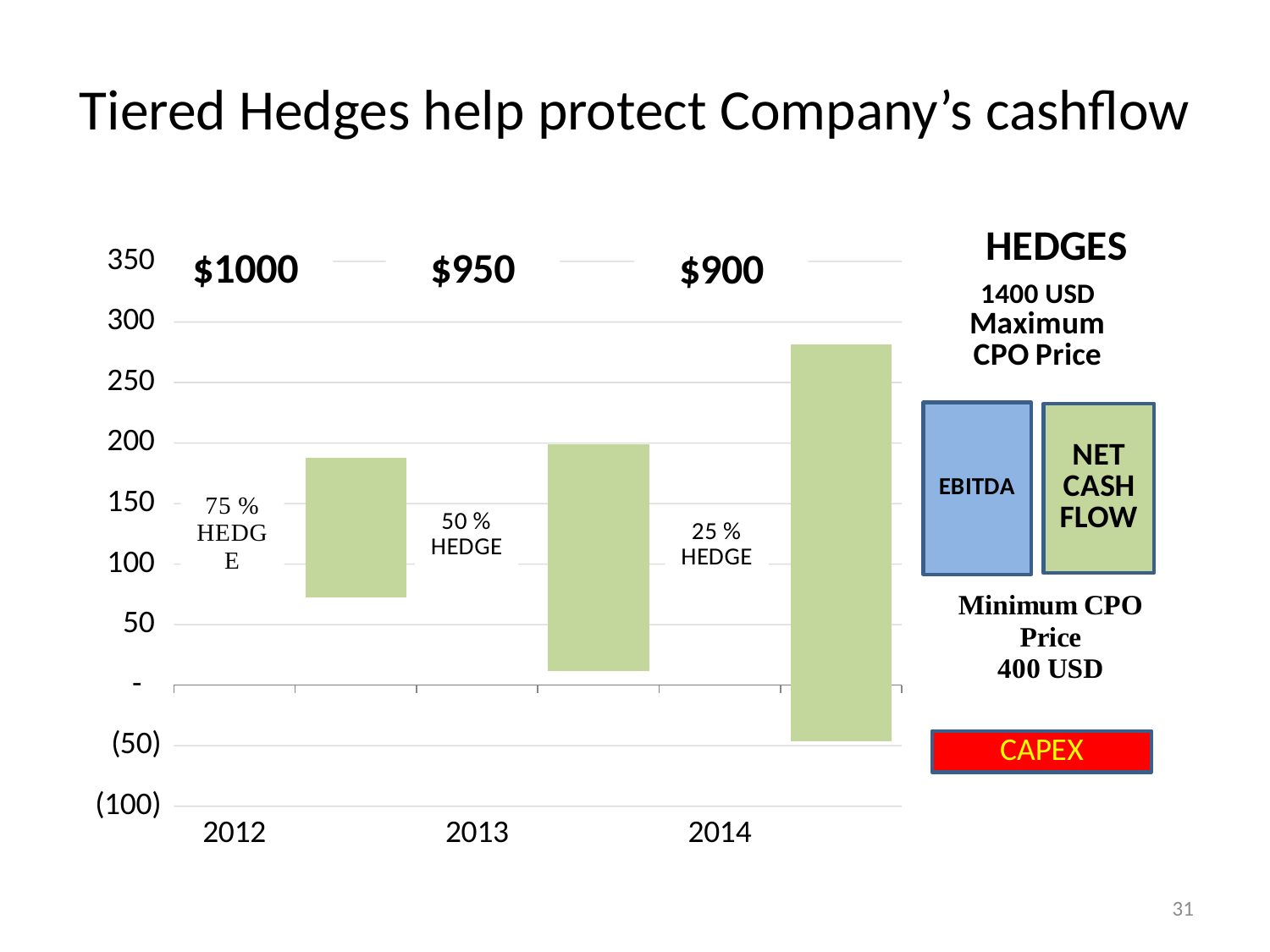
Is the bottom of the 2014 bar greater or less than 50? less What price is labelled above the 2012 bar? $1000 What hedge percentage is labelled for 2014 on the chart? 25 % HEDGE How many years are shown on the x axis of the chart? 3 Do the tops of the bars rise or fall from 2012 to 2014? rise Is the top of the 2012 bar greater or less than 200? less Which year has the tallest bar in the chart? 2014 What is the title of the slide containing the chart? Tiered Hedges help protect Company's cashflow What kind of chart is shown on the slide? bar chart What hedge percentage is labelled for 2012 on the chart? 75 % HEDGE Is the top of the 2014 bar greater or less than 250? greater What price is labelled above the 2013 bar? $950